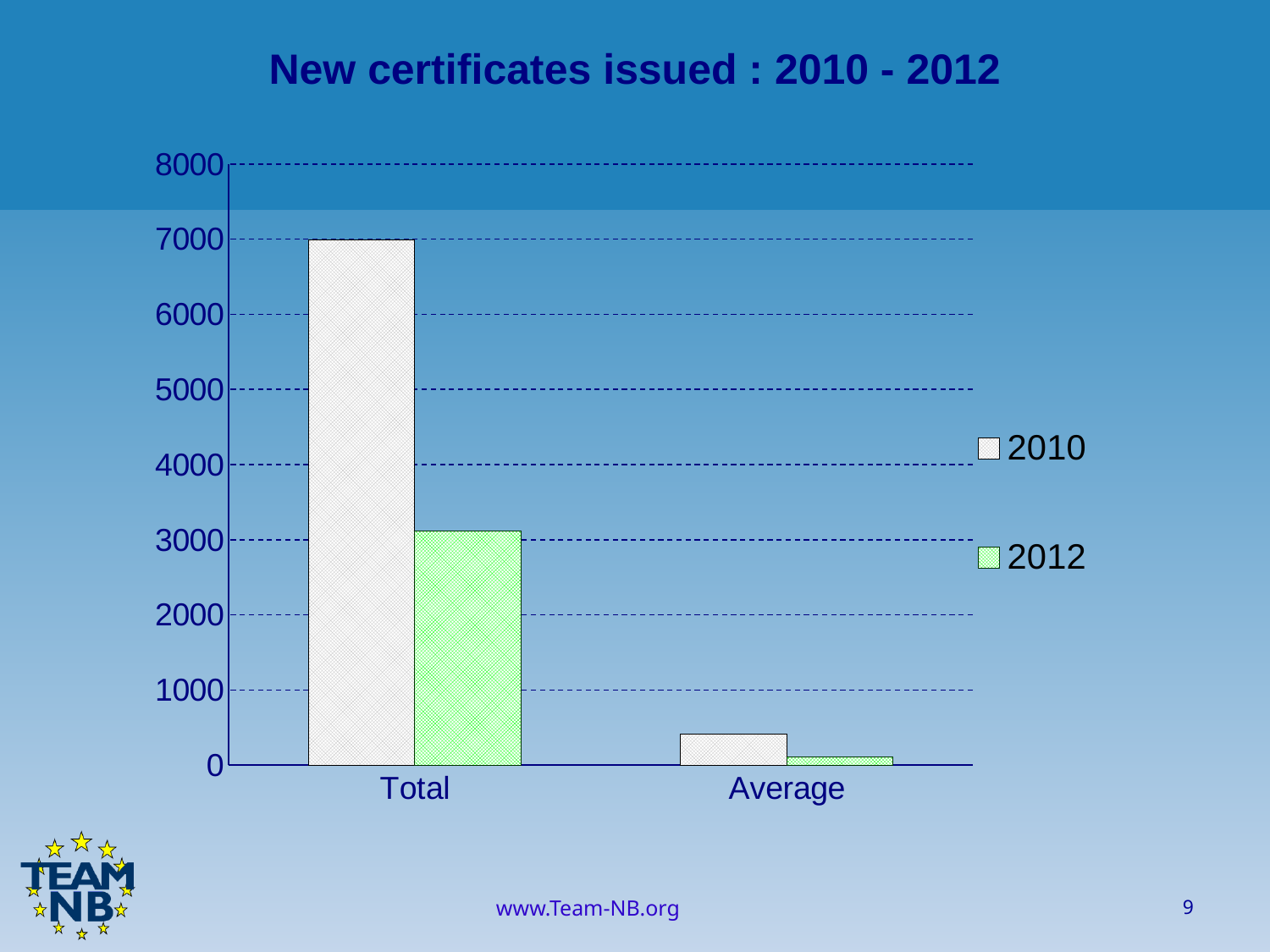
Is the 2012 value for Total greater or less than 4000? less Which series does the legend list first? 2010 Is the 2010 value for Total greater or less than 6000? greater How many categories are shown on the x axis? 2 For Average, which year has the larger value, 2010 or 2012? 2010 What kind of chart is shown on the slide? bar chart Is the 2012 value for Total greater or less than 2000? greater Which bar is the tallest in the chart? 2010 Total What is the title of the chart? New certificates issued : 2010 - 2012 For Total, which year has the larger value, 2010 or 2012? 2010 How many series does the legend list? 2